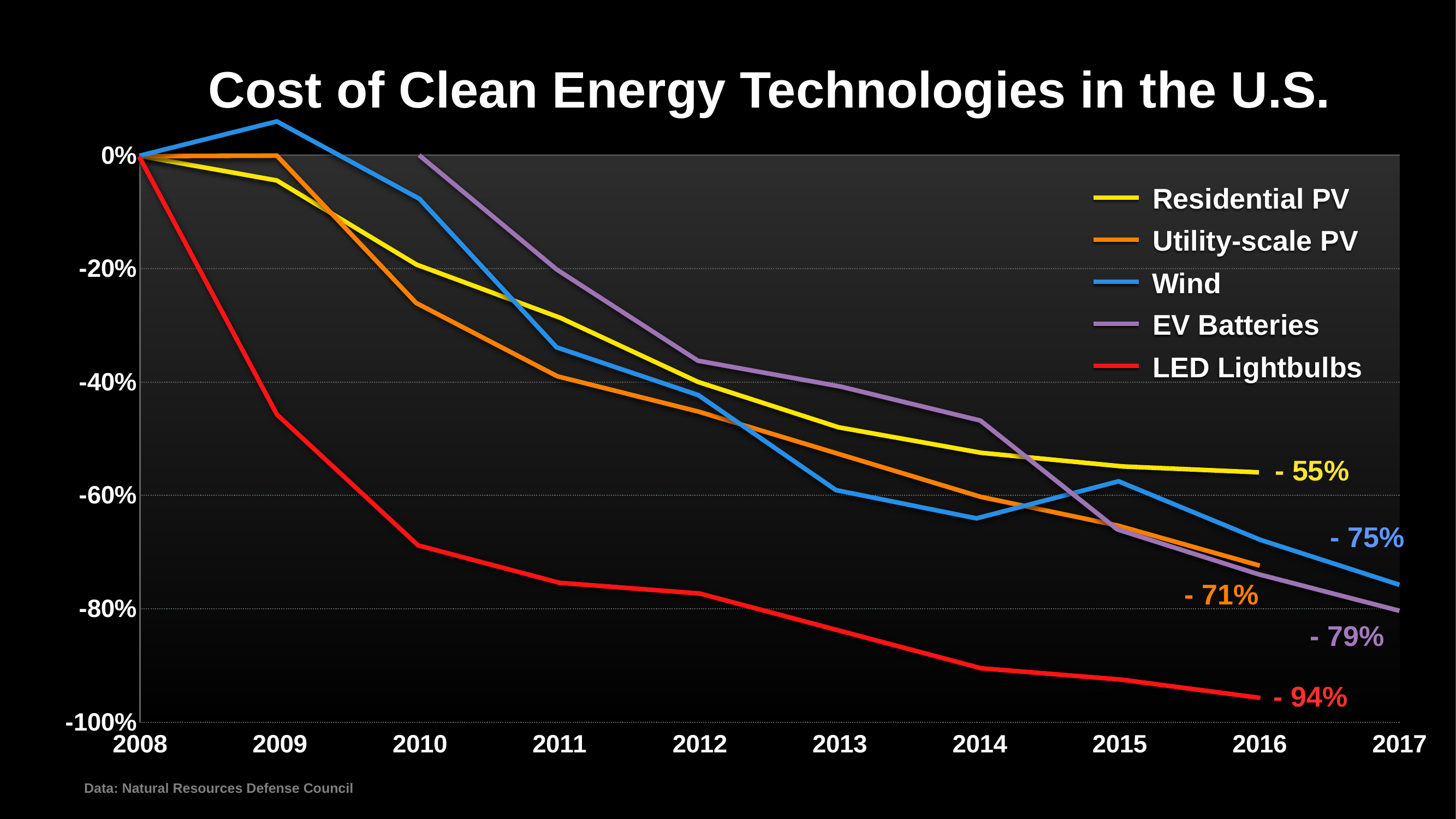
Which has a larger labelled cost decline, Utility-scale PV or EV Batteries? EV Batteries What is the labelled final value for LED Lightbulbs? - 94% Which technology shows the smallest cost decline by the end of its line? Residential PV What is the labelled final value for EV Batteries? - 79% What is the title of the chart? Cost of Clean Energy Technologies in the U.S. Is the value for Wind in 2011 greater or less than -20%? less What type of chart is shown on the slide? Line chart What is the labelled final value for Residential PV? - 55% What is the labelled final value for Wind? - 75% How many series does the legend list? 5 Which technology shows the largest cost decline by the end of its line? LED Lightbulbs How many years are shown on the x axis? 10